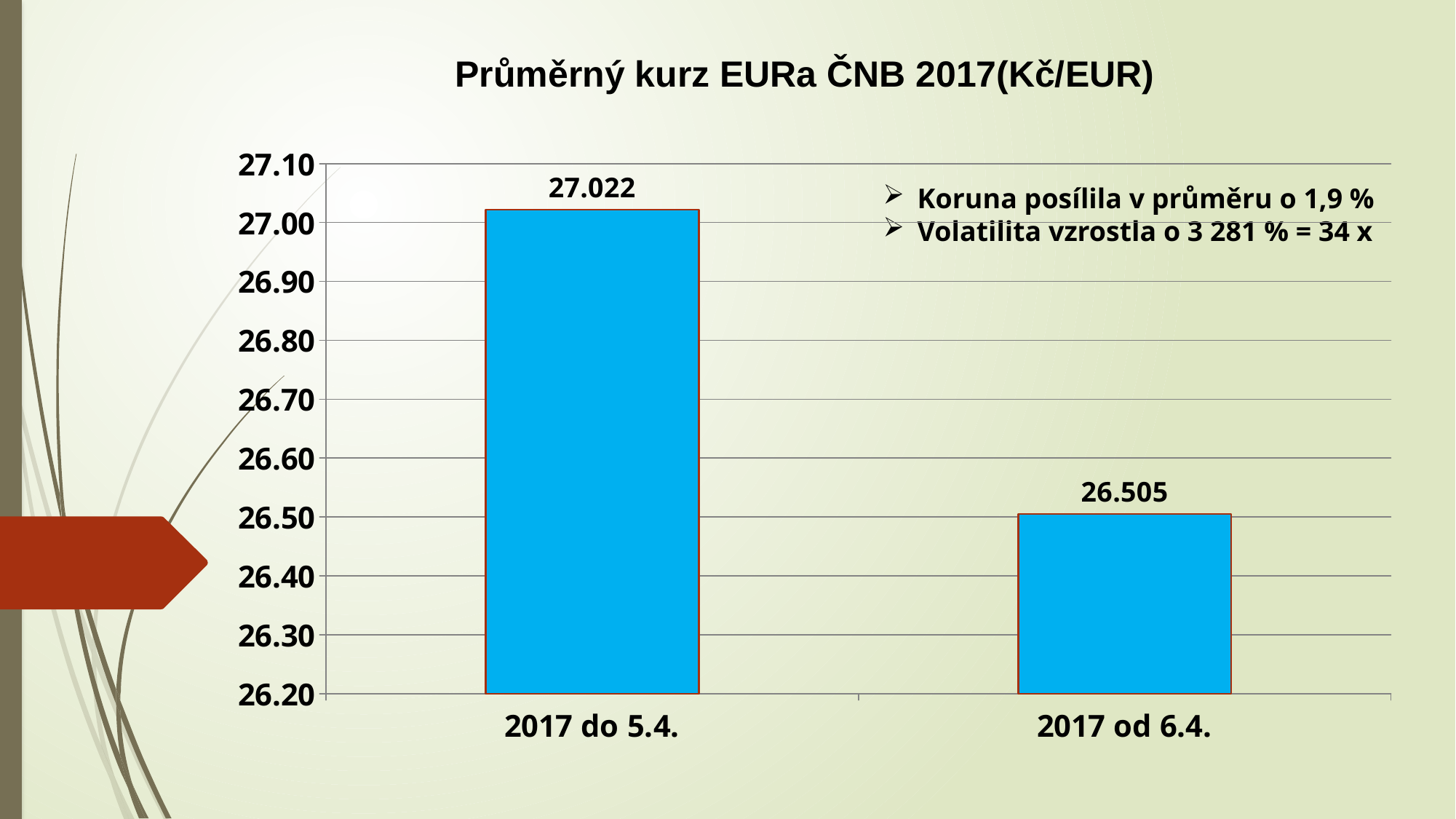
What is the title of the chart? Průměrný kurz EURa ČNB 2017(Kč/EUR) Which category has the highest value? 2017 do 5.4. Which is larger, the value for 2017 do 5.4. or the value for 2017 od 6.4.? 2017 do 5.4. What kind of chart is shown on the slide? bar chart Is the value for 2017 od 6.4. greater or less than 26.60? less What is the value for 2017 od 6.4.? 26.505 How many categories are shown on the chart? 2 Which category has the lowest value? 2017 od 6.4. Is the value for 2017 do 5.4. greater or less than 27.00? greater Do the values rise or fall from left to right along the x axis? fall What is the difference between the values for 2017 do 5.4. and 2017 od 6.4.? 0.517 What is the value for 2017 do 5.4.? 27.022